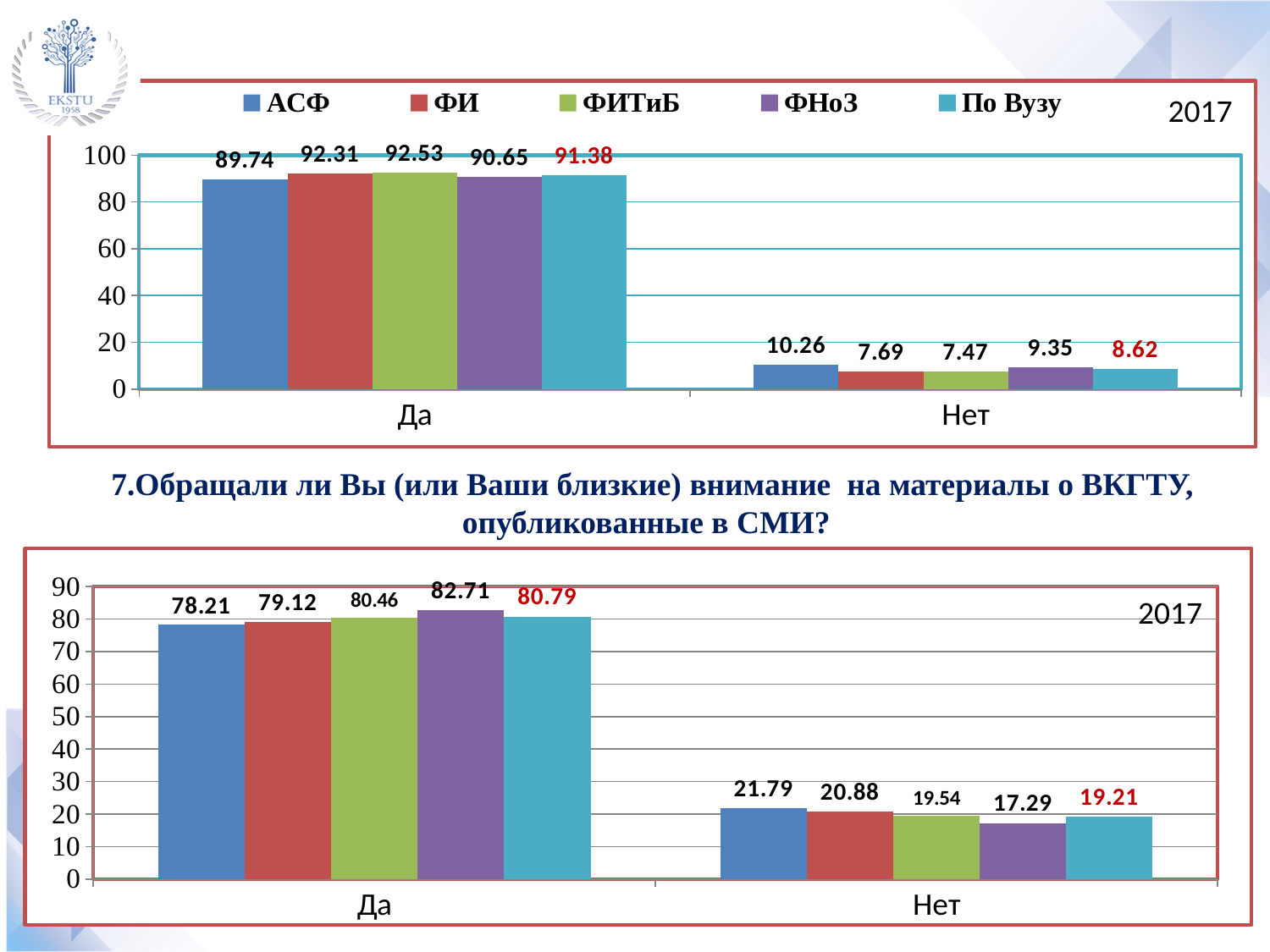
In the bottom chart, which is larger in the Да category: АСФ or ФИ? ФИ In the bottom chart, which series has the lowest value in the Нет category? ФНоЗ In the bottom chart, what is the value for ФНоЗ in the Да category? 82.71 In the top chart, what is the value for По Вузу in the Нет category? 8.62 In the top chart, what is the difference between the АСФ and ФИТиБ values in the Нет category? 2.79 In the top chart, which series has the highest value in the Нет category? АСФ In the top chart, which series has the lowest value in the Да category? АСФ In the bottom chart, what is the value for ФИТиБ in the Нет category? 19.54 How many series does the legend of the top chart list? 5 What kind of chart is the bottom chart? Bar chart In the bottom chart, what is the difference between the ФНоЗ and АСФ values in the Да category? 4.50 In the top chart, what is the value for ФИ in the Да category? 92.31